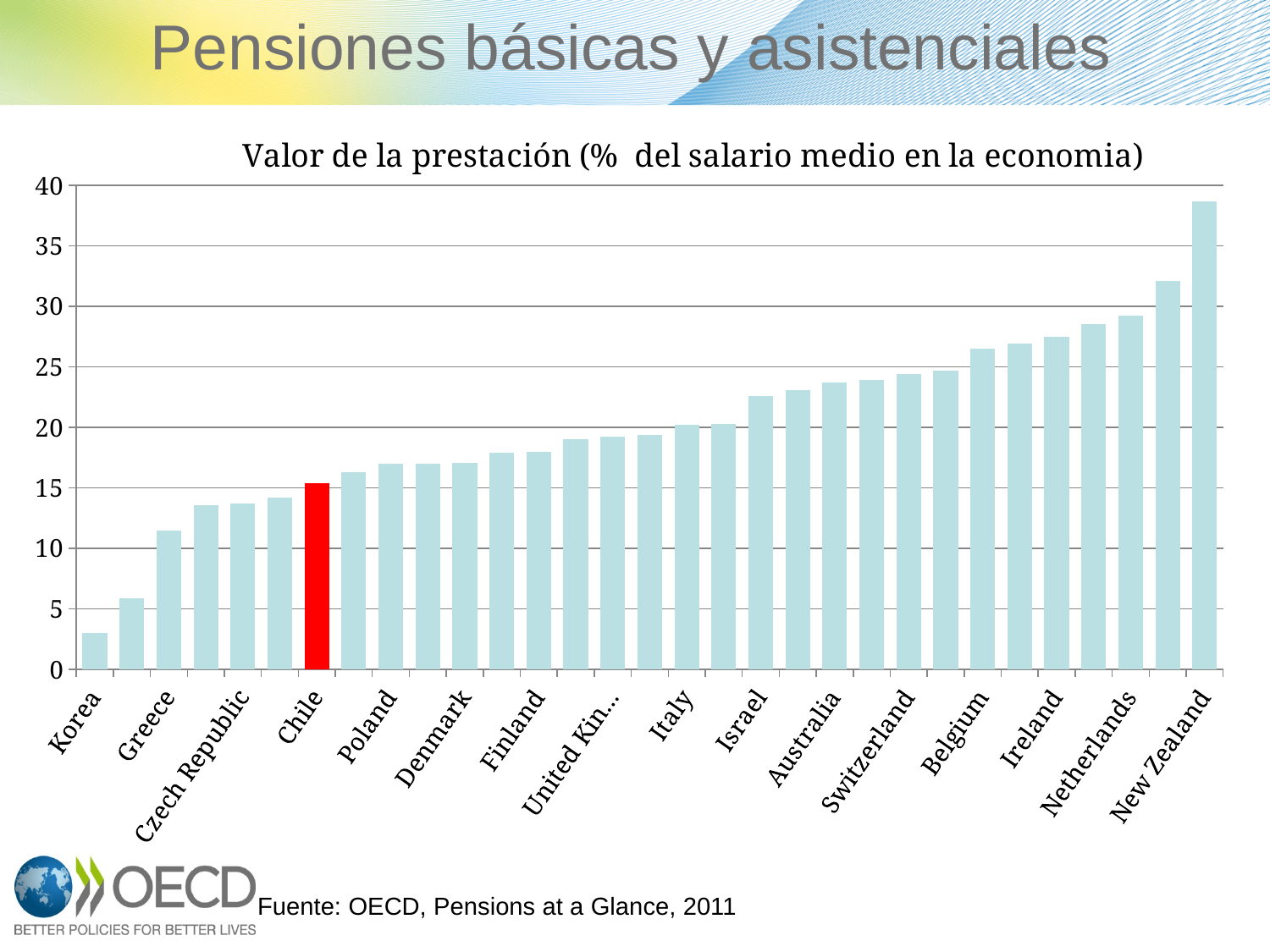
Is the value for Belgium greater or less than 25? greater Do the bar values rise or fall from left to right along the x axis? rise Is the value for New Zealand greater or less than 35? greater Is the value for Chile greater or less than 10? greater Which country's bar is highlighted in red? Chile What kind of chart is shown on the slide? bar chart Which country has the lowest value in the chart? Korea Which country has the highest value in the chart? New Zealand Which has a larger value, Chile or Netherlands? Netherlands